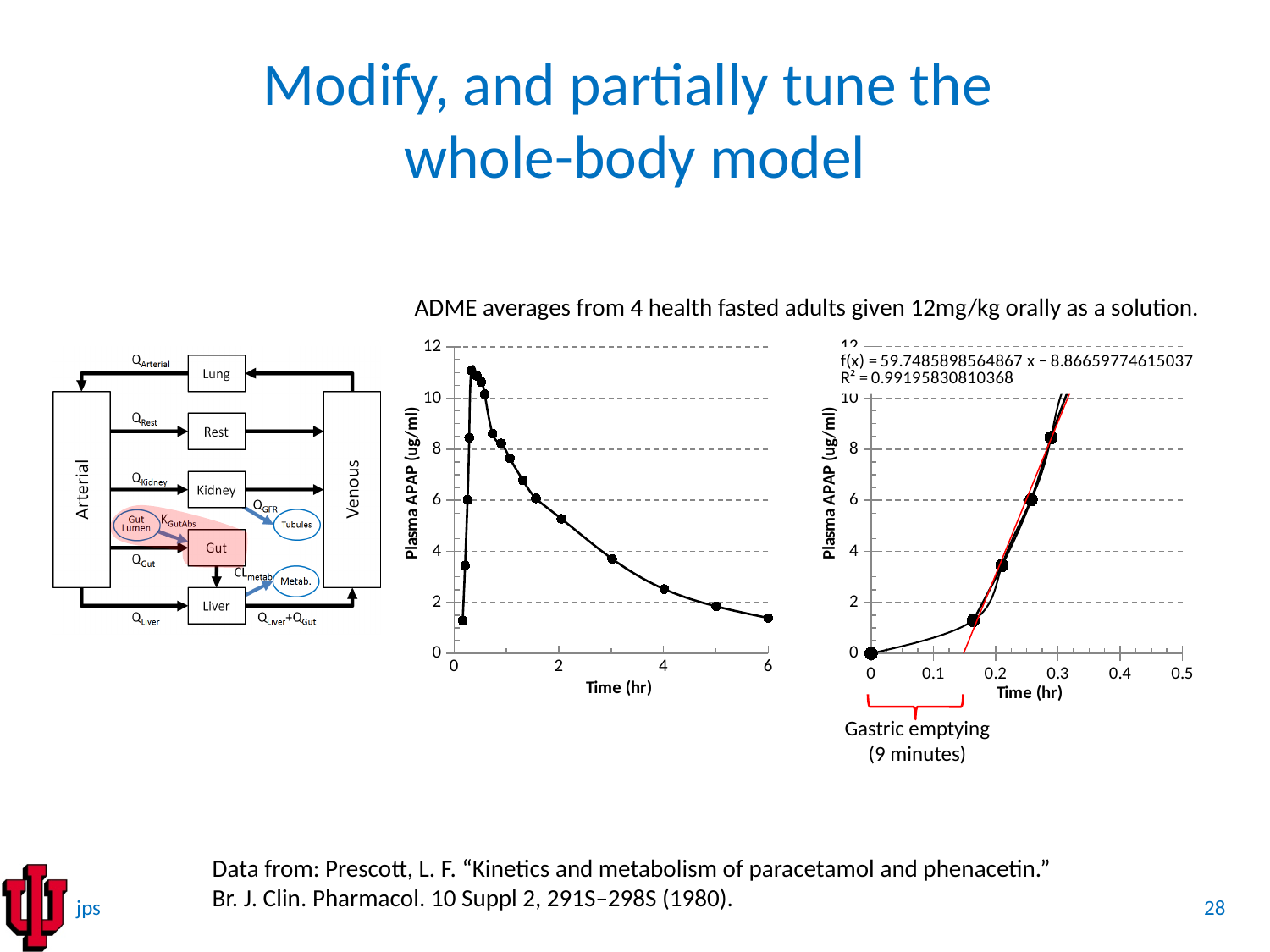
On the left chart, what is the y-axis title? Plasma APAP (ug/ml) What kind of chart is the left chart (Time 0 to 6 hr)? line chart On the left chart, is the plasma APAP value at 6 hr greater or less than 2? less On the left chart, is the plasma APAP value at 2 hr greater or less than 4? greater On the right chart (Time 0 to 0.5 hr), do the plasma APAP values rise or fall as time increases? rise On the right chart, what R² value is printed for the fitted line? R² = 0.99195830810368 On the left chart, which is larger: the plasma APAP value at 2 hr or at 4 hr? 2 hr On the left chart, what is the x-axis title? Time (hr) On the left chart, do the plasma APAP values rise or fall between 1 hr and 6 hr? fall On the left chart, is the peak plasma APAP value greater or less than 10? greater